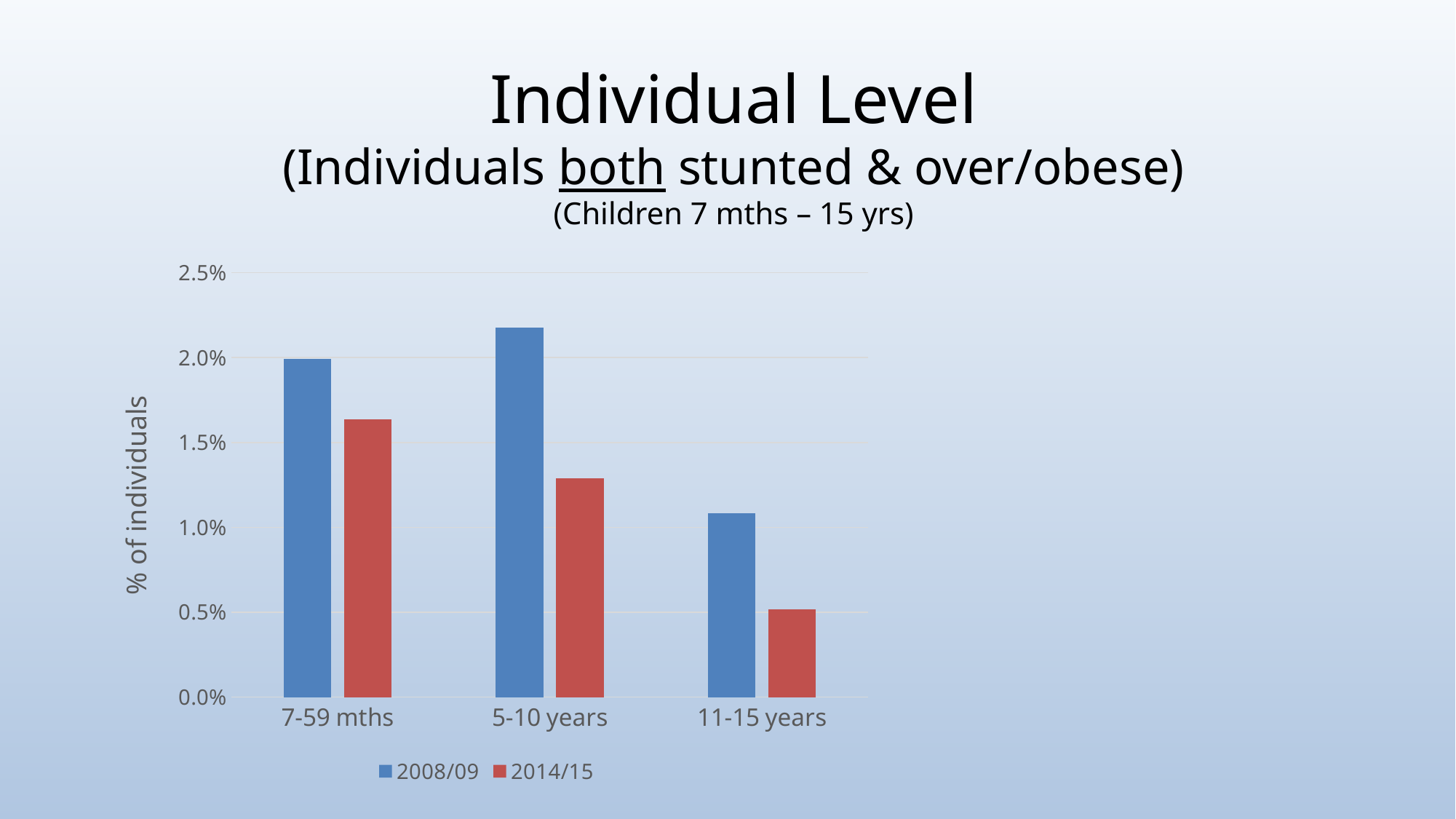
How many series does the legend list? 2 Is the 2014/15 value for 7-59 mths greater or less than 1.5%? greater Do the 2014/15 values rise or fall moving from 7-59 mths to 11-15 years? fall What is the label on the vertical axis of the chart? % of individuals How many age-group categories are shown on the x axis? 3 Which age group has the lowest value for the 2014/15 series? 11-15 years Is the 2014/15 value for 5-10 years greater or less than 1.5%? less Is the 2014/15 value for 11-15 years greater or less than 1.0%? less What kind of chart is shown on the slide? bar chart For the 11-15 years group, which series has the larger value, 2008/09 or 2014/15? 2008/09 Which age group has the highest value for the 2008/09 series? 5-10 years